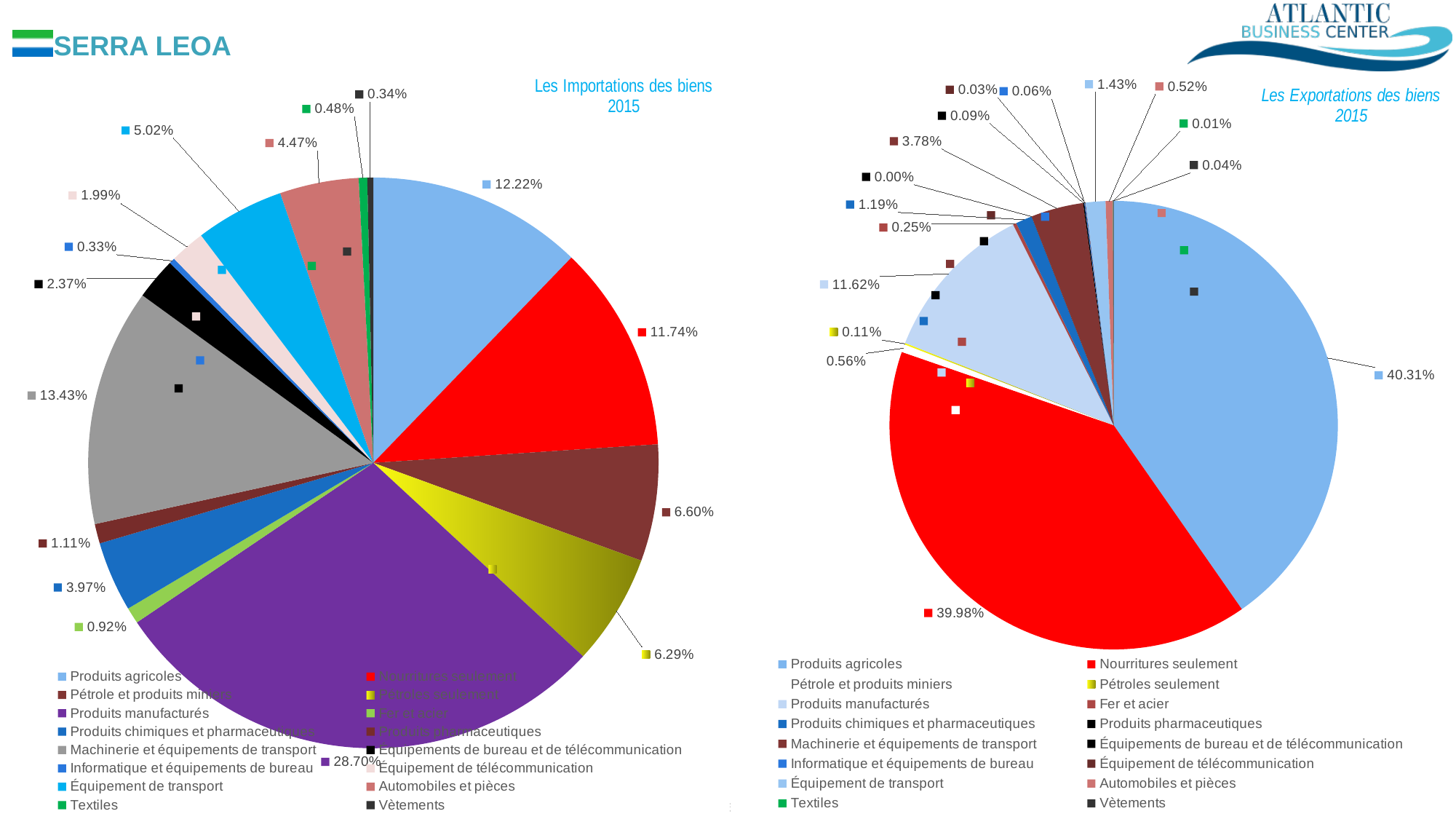
In the 'Les Importations des biens 2015' chart, which is larger: Produits agricoles or Nourritures seulement? Produits agricoles In the 'Les Exportations des biens 2015' chart, what is the share for Produits agricoles? 40.31% In the 'Les Exportations des biens 2015' chart, what is the share for Produits manufacturés? 11.62% How many entries does the legend of the 'Les Exportations des biens 2015' chart list? 16 In the 'Les Exportations des biens 2015' chart, what is the share for Nourritures seulement? 39.98% In the 'Les Importations des biens 2015' chart, which category has the largest share? Produits manufacturés In the 'Les Importations des biens 2015' chart, what is the difference between Produits manufacturés and Machinerie et équipements de transport? 15.27% What type of chart is used for 'Les Importations des biens 2015'? pie chart In the 'Les Importations des biens 2015' chart, what is the share for Machinerie et équipements de transport? 13.43% How many pie charts are shown on the slide? 2 In the 'Les Importations des biens 2015' chart, what is the share for Produits manufacturés? 28.70% In the 'Les Exportations des biens 2015' chart, what is the difference between Produits agricoles and Nourritures seulement? 0.33%